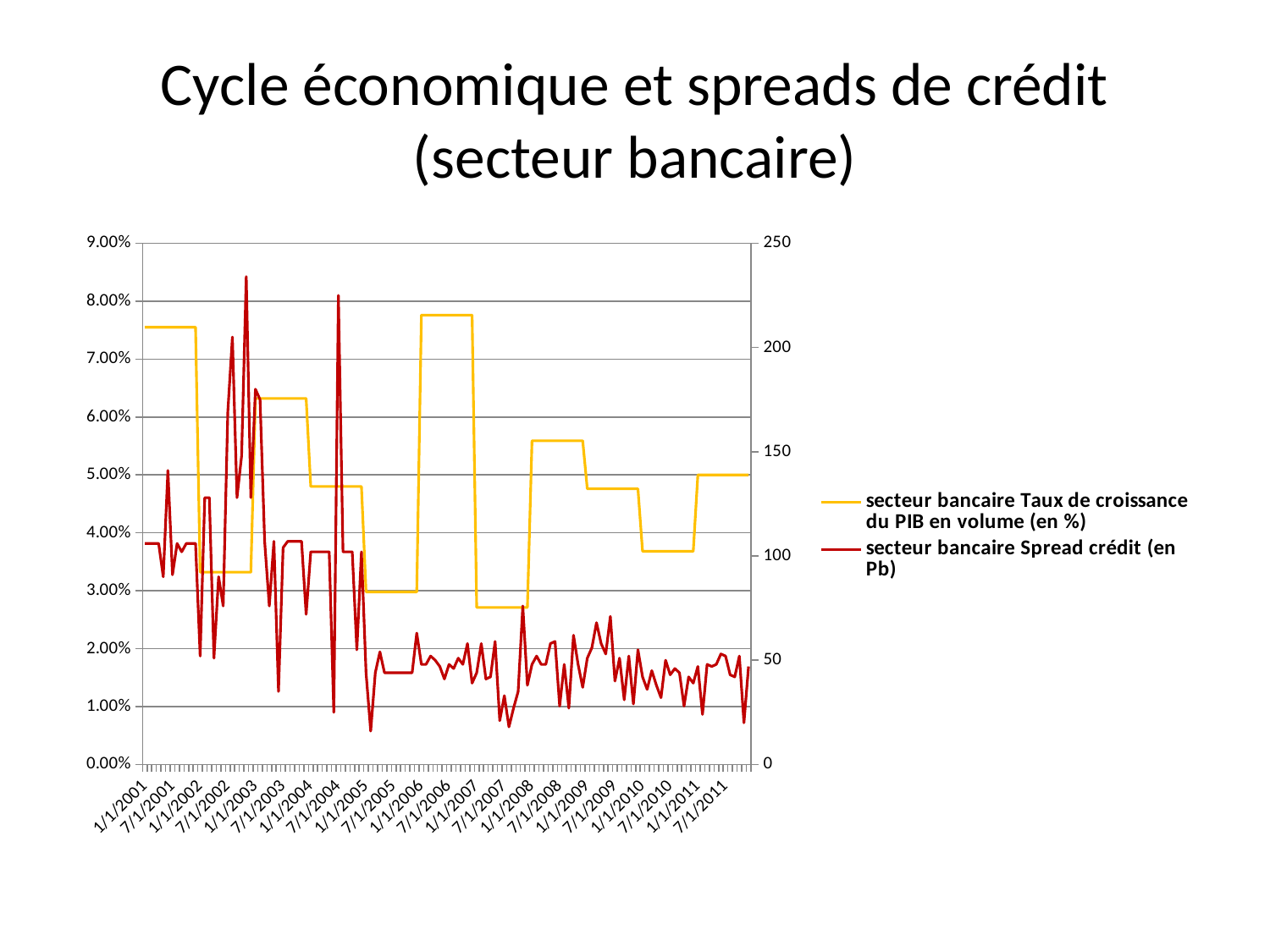
Is the value of 'secteur bancaire Taux de croissance du PIB en volume (en %)' at 7/1/2007 greater or less than 3.00%? less Is the highest peak of 'secteur bancaire Spread crédit (en Pb)', reached around 1/1/2003, greater or less than 200 on the right axis? greater Is the value of 'secteur bancaire Taux de croissance du PIB en volume (en %)' at 7/1/2008 greater or less than 5.00%? greater How many series does the legend list? 2 Which colour is used for the series 'secteur bancaire Spread crédit (en Pb)'? red Overall, does the 'secteur bancaire Spread crédit (en Pb)' series rise or fall from 2001 to 2011? fall What kind of chart is shown on the slide? line chart What is the title of the chart on the slide? Cycle économique et spreads de crédit (secteur bancaire)